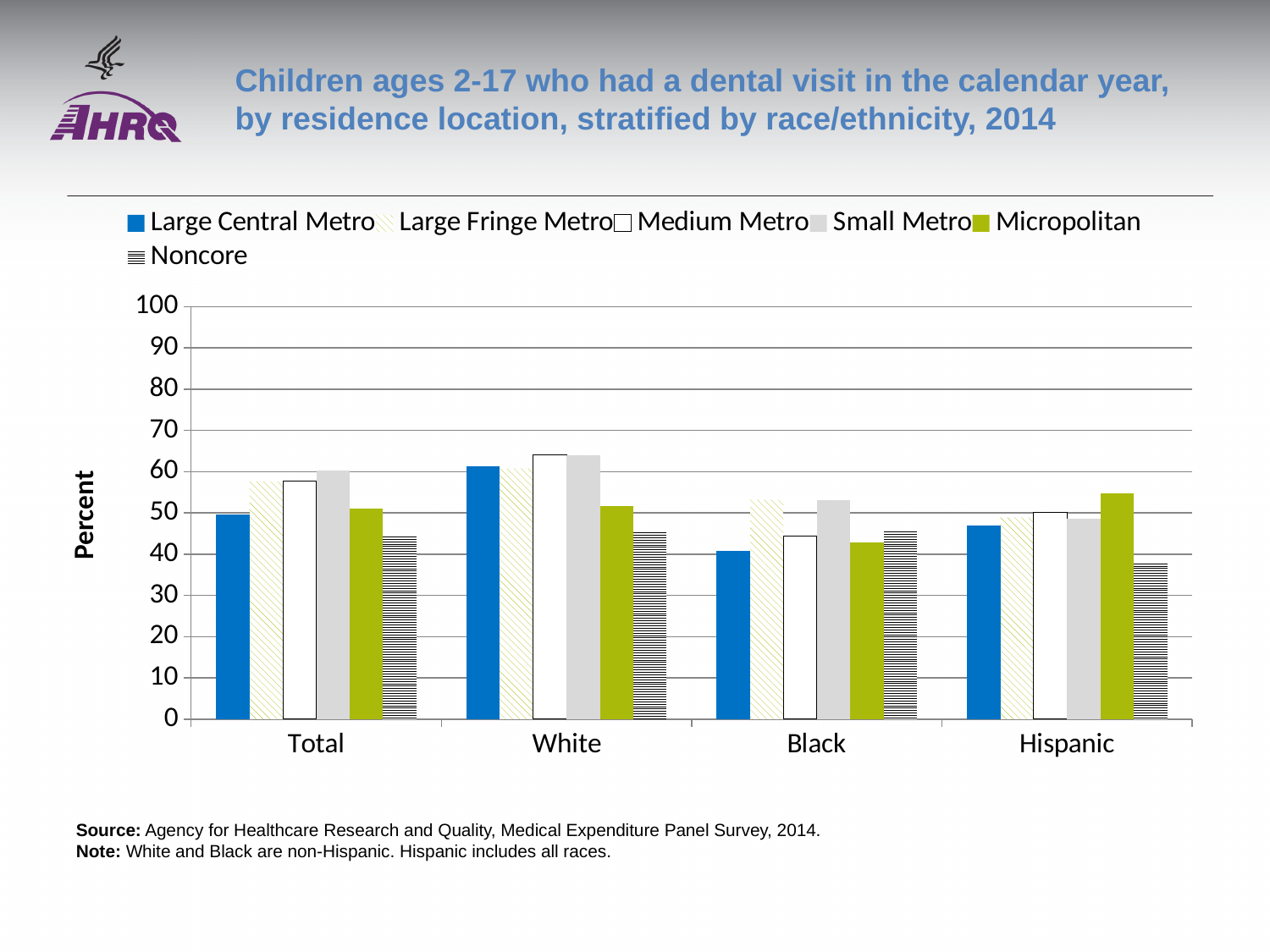
Is the Noncore value for Hispanic greater or less than 40? less How many race/ethnicity categories are shown on the x axis? 4 Which residence location has the lowest value for Hispanic? Noncore How many series does the legend list? 6 What kind of chart is shown on the slide? Bar chart Is the Large Central Metro value for Black greater or less than 50? less Is the Small Metro value for Total greater or less than 50? greater Which residence location has the lowest value for White? Noncore Which is larger: the Large Central Metro value for Total or the Large Central Metro value for White? White What is the label on the y axis? Percent For Hispanic, which is larger: the Micropolitan value or the Noncore value? Micropolitan